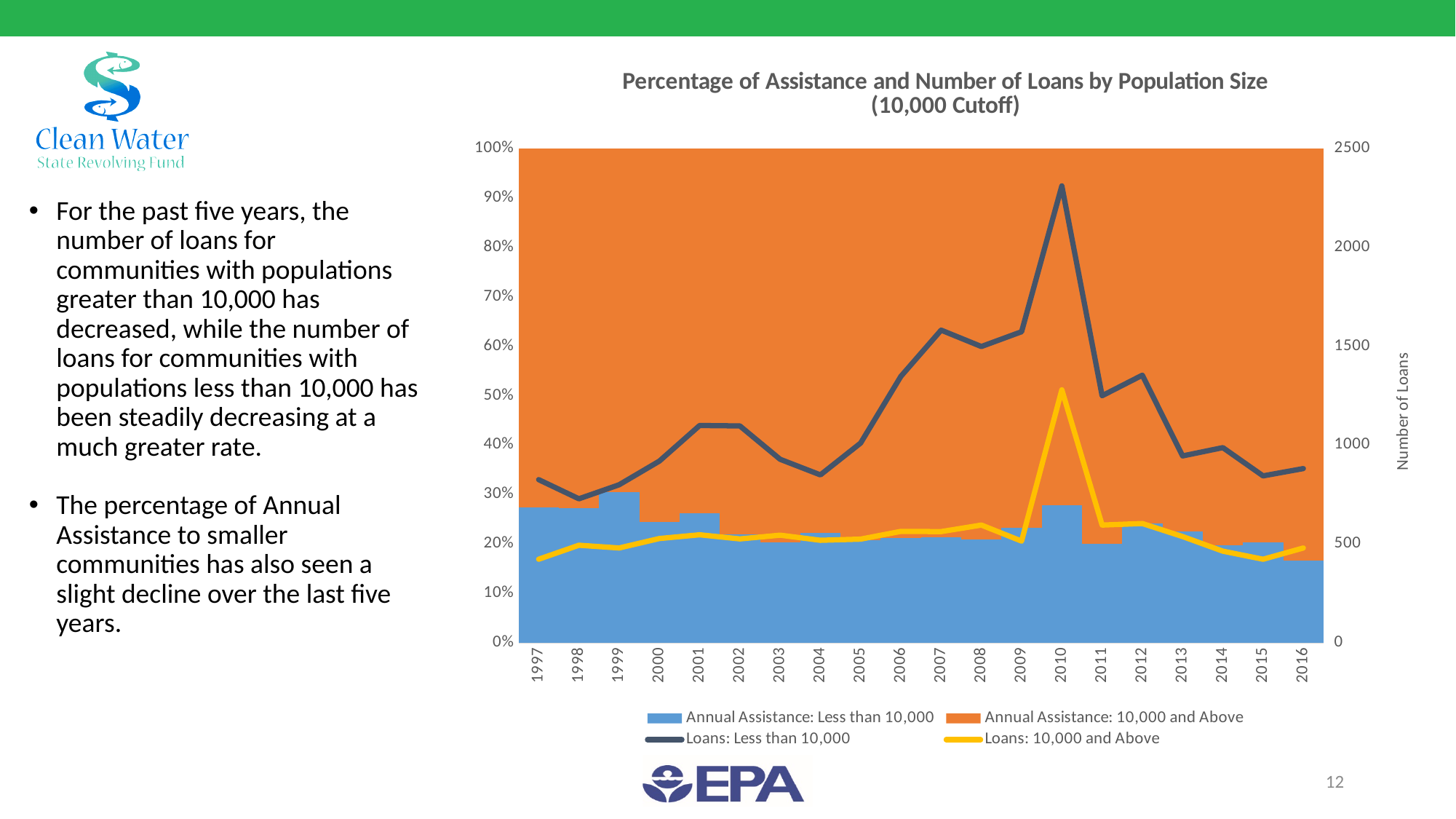
Is the value for Loans: 10,000 and Above in 1997 greater or less than 500? less In 2007, which series has the higher value: Loans: Less than 10,000 or Loans: 10,000 and Above? Loans: Less than 10,000 What is the title of the chart? Percentage of Assistance and Number of Loans by Population Size (10,000 Cutoff) Is the value for Loans: Less than 10,000 in 2010 greater or less than 2000? greater What kind of chart is this? Combined stacked bar and line chart How many years are shown along the x axis of the chart? 20 Does the Loans: Less than 10,000 line rise or fall from 2012 to 2015? fall What is the label of the right-hand vertical axis? Number of Loans In which year does the Loans: 10,000 and Above line reach its highest value? 2010 How many series does the chart legend list? 4 Is the value for Annual Assistance: Less than 10,000 in 2016 greater or less than 20%? less In which year does the Loans: Less than 10,000 line reach its highest value? 2010